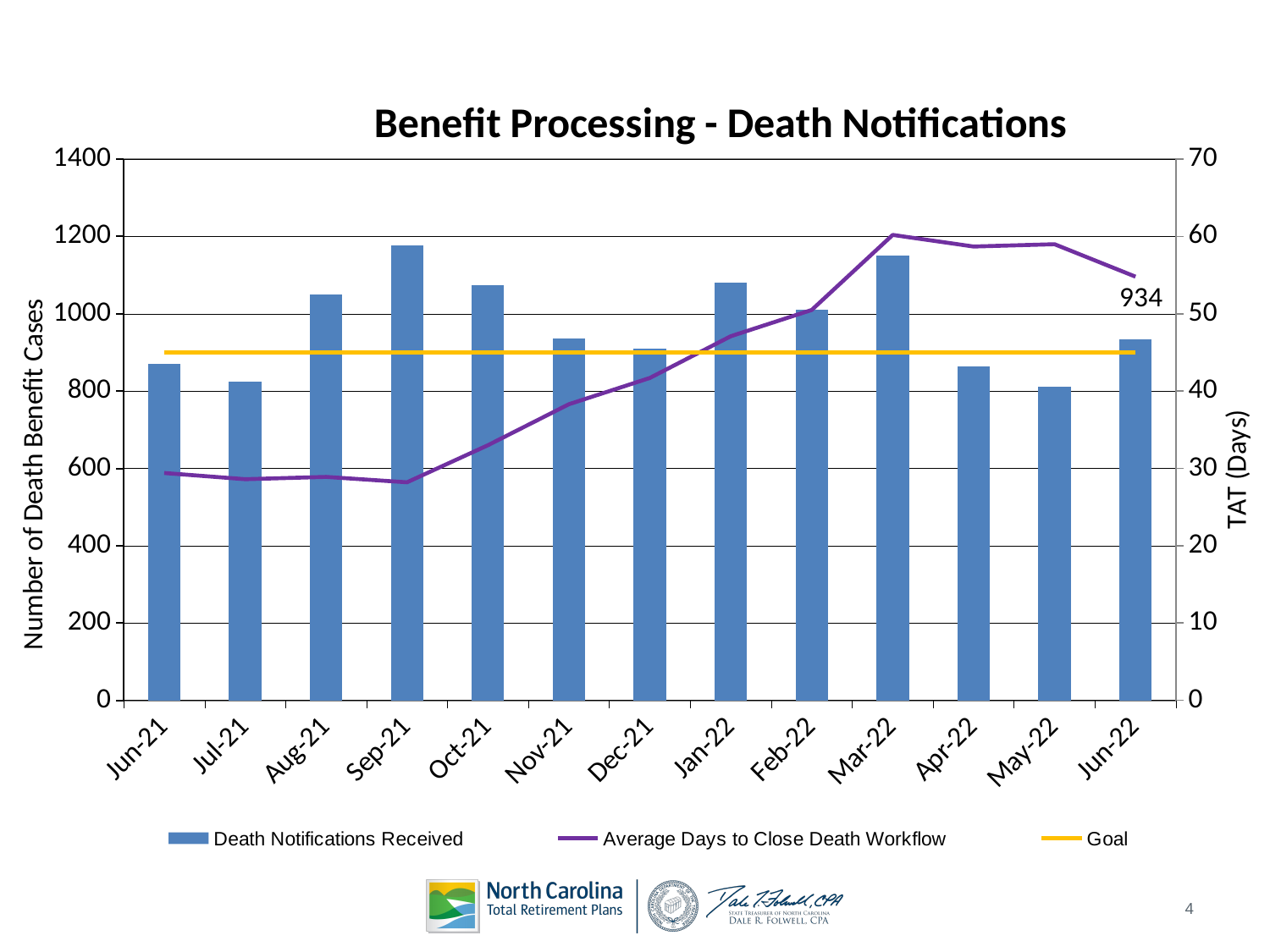
Is the value of Death Notifications Received for Sep-21 greater or less than 1000? greater How many months are shown on the x axis? 13 What kind of chart is this? Bar chart with line series Which is larger, Death Notifications Received for Sep-21 or for Jul-21? Sep-21 How many series does the legend list? 3 Is the value of Death Notifications Received for Jul-21 greater or less than 1000? less What is the label of the right-hand vertical axis? TAT (Days) Does the Average Days to Close Death Workflow line rise or fall from Sep-21 to Mar-22? rise Is the Average Days to Close Death Workflow for Mar-22 greater or less than 50? greater What is the title of the chart? Benefit Processing - Death Notifications What is the value of Death Notifications Received for Jun-22? 934